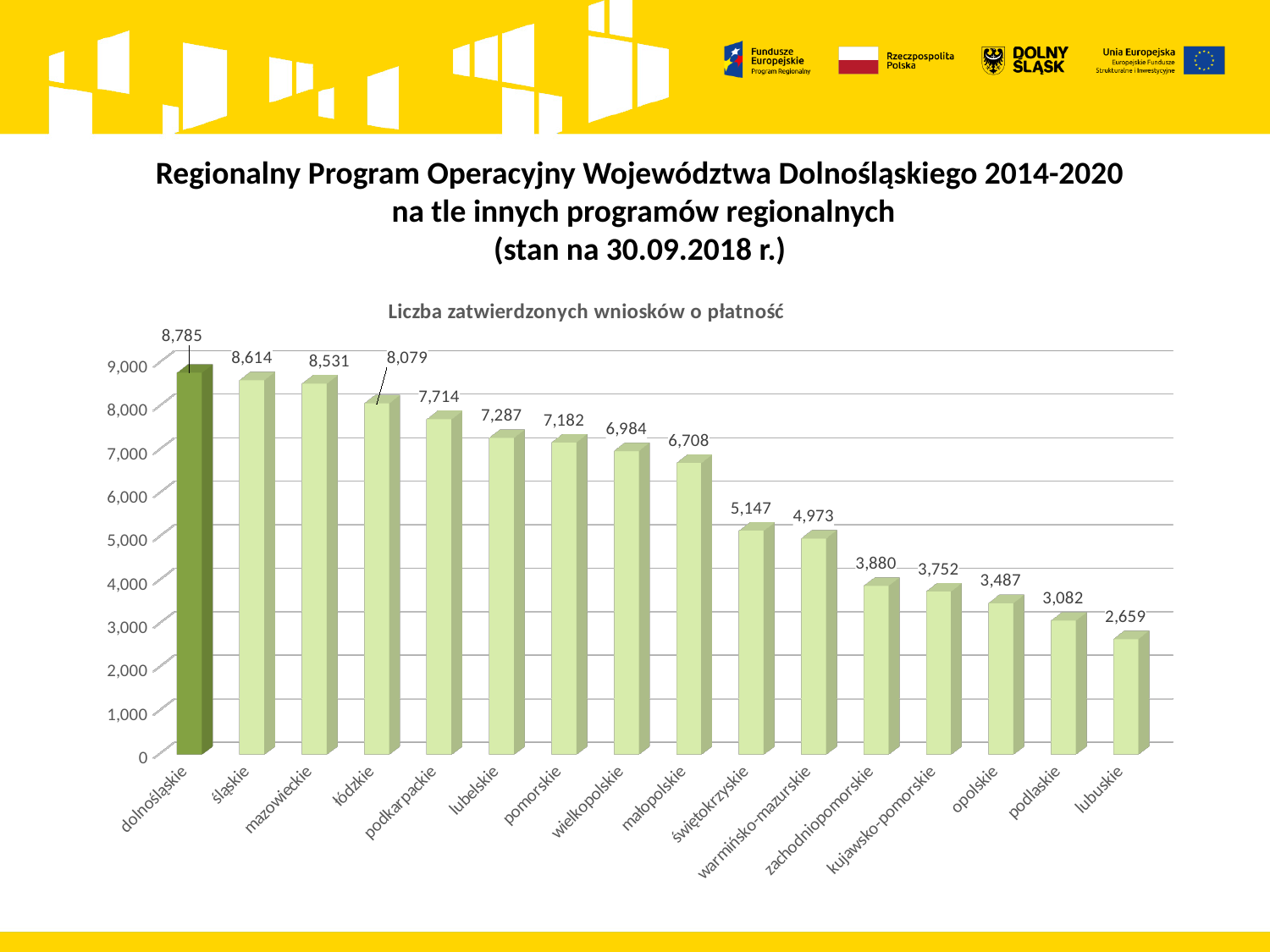
Which region has the highest number of approved payment applications? dolnośląskie What kind of chart is shown on the slide? bar chart How many regions are shown on the chart? 16 Is the value for podlaskie greater or less than 3,000? greater Which region has the lowest number of approved payment applications? lubuskie What is the value for dolnośląskie? 8,785 What is the title of the chart? Liczba zatwierdzonych wniosków o płatność What is the difference between the values for dolnośląskie and śląskie? 171 What is the value for małopolskie? 6,708 What is the value for opolskie? 3,487 What is the difference between the values for świętokrzyskie and lubuskie? 2,488 Which is larger, the value for pomorskie or the value for wielkopolskie? pomorskie